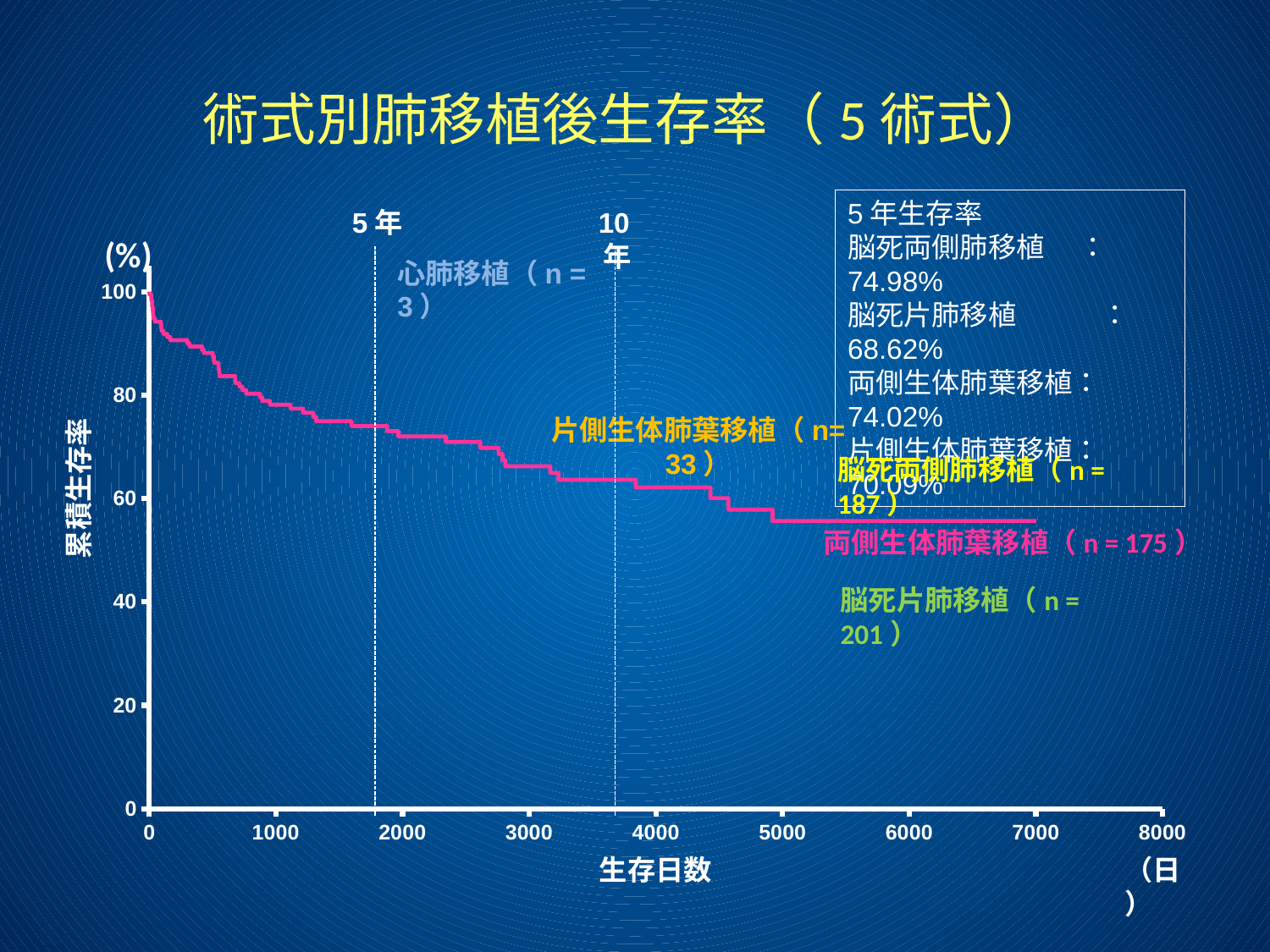
Does the pink survival curve rise or fall as 生存日数 increases? fall How many patients (n) are in the 脳死片肺移植 group? 201 What is the difference between the 5-year survival rates of 脳死両側肺移植 and 脳死片肺移植? 6.36% Which procedure has the lowest 5-year survival rate listed in the 5年生存率 box? 脳死片肺移植 Which procedure has the highest 5-year survival rate listed in the 5年生存率 box? 脳死両側肺移植 According to the 5年生存率 box, what is the 5-year survival rate for 脳死片肺移植? 68.62% How many patients (n) are in the 両側生体肺葉移植 group? 175 According to the 5年生存率 box, what is the 5-year survival rate for 脳死両側肺移植? 74.98% Which has the higher 5-year survival rate, 脳死両側肺移植 or 両側生体肺葉移植? 脳死両側肺移植 According to the 5年生存率 box, what is the 5-year survival rate for 両側生体肺葉移植? 74.02% What kind of chart is shown on the slide? line chart Is the value of the pink 両側生体肺葉移植 curve at 7000 days greater or less than 60? less